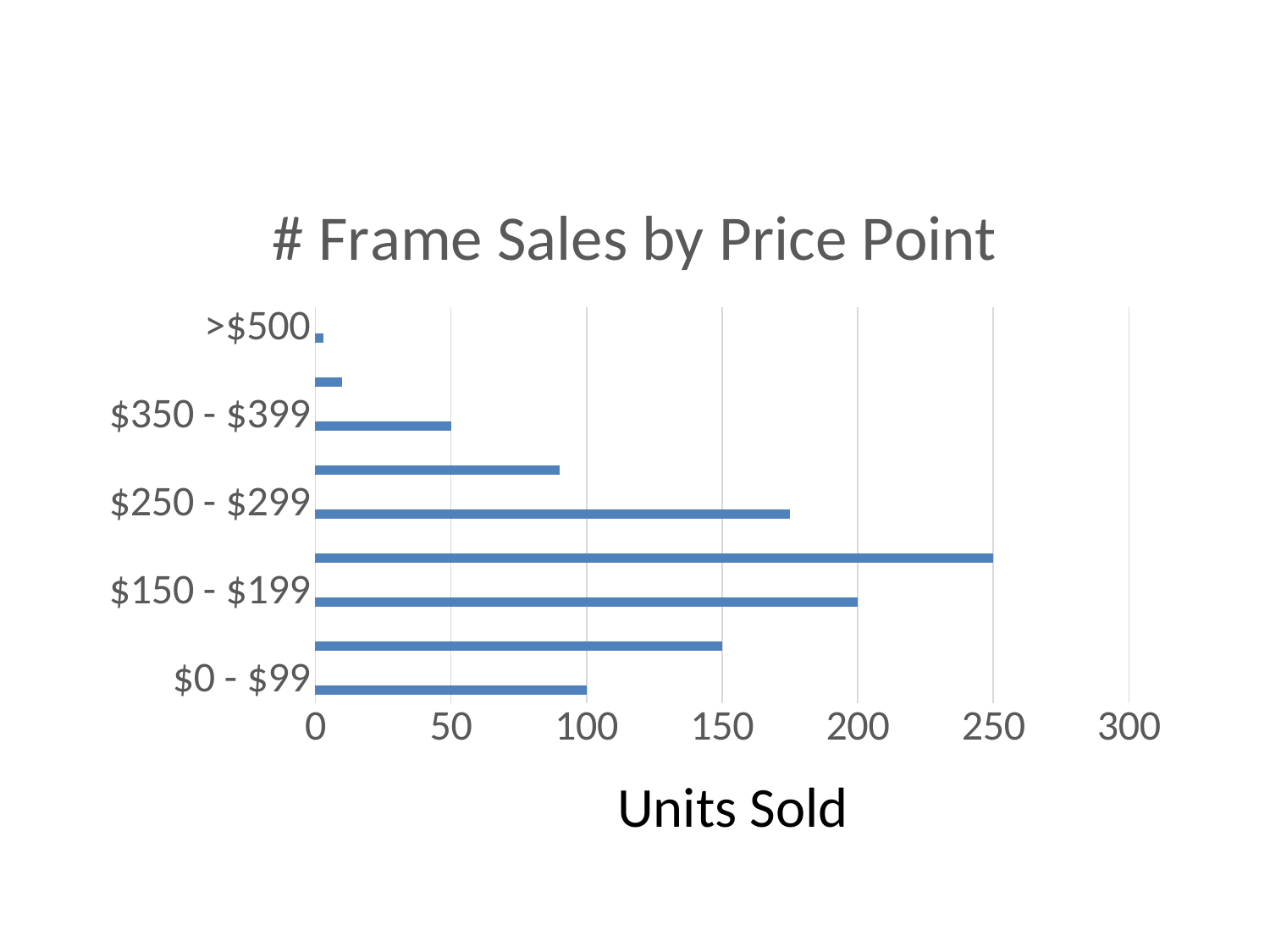
Which price point has the lowest units sold? >$500 Is the value for $250 - $299 greater or less than 150? greater What is the difference in units sold between the $150 - $199 and $0 - $99 price points? 100 Is the value for >$500 greater or less than 50? less How many units were sold at the $350 - $399 price point? 50 How many units were sold at the $150 - $199 price point? 200 How many units were sold at the $0 - $99 price point? 100 What is the label of the horizontal axis? Units Sold How many bars are plotted in the chart? 9 What type of chart is shown on the slide? bar chart What is the title of the chart? # Frame Sales by Price Point Which price point sold more units, $150 - $199 or $350 - $399? $150 - $199